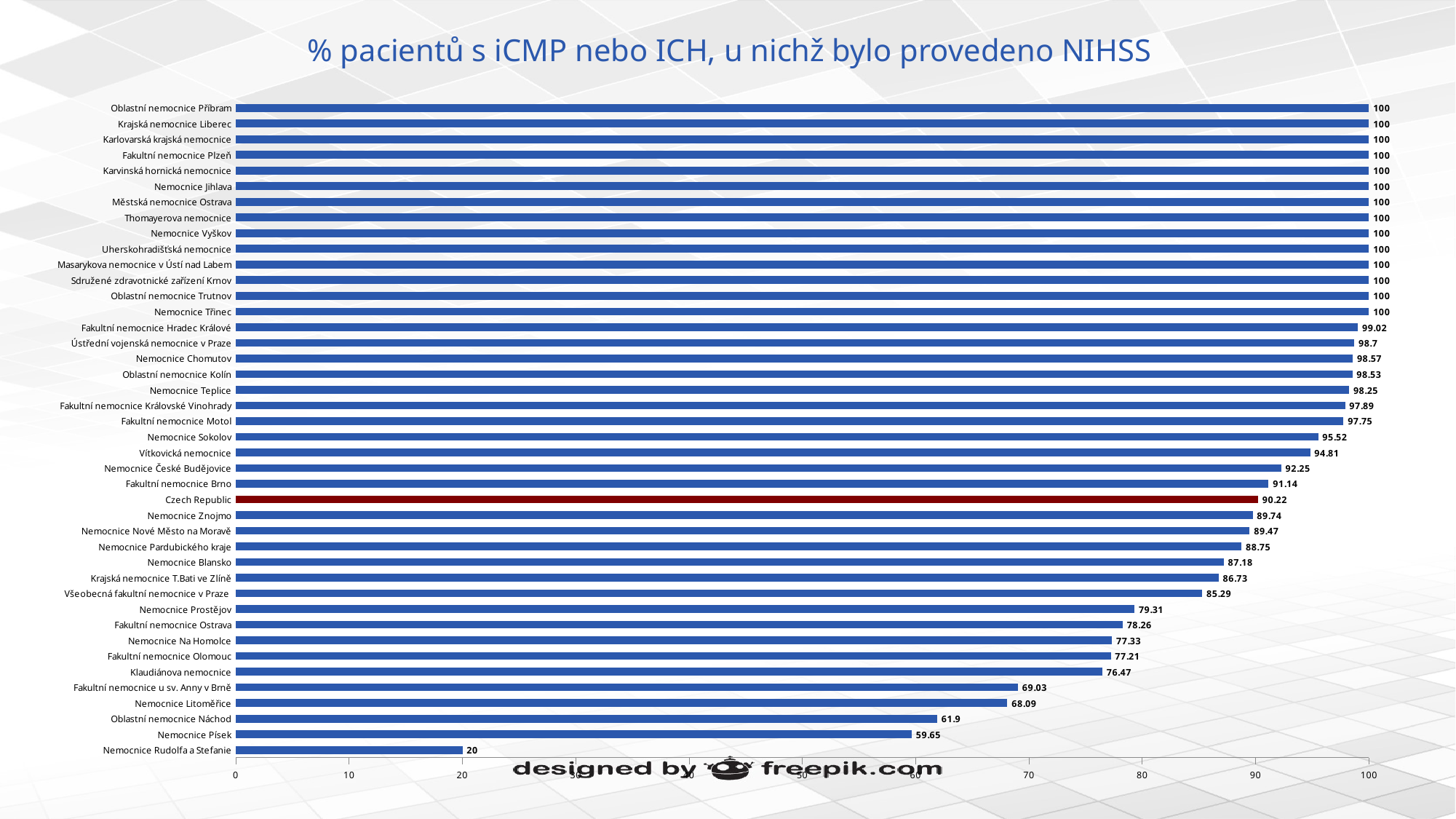
What kind of chart is shown on the slide? Bar chart Which category has the lowest value? Nemocnice Rudolfa a Stefanie What is the value for Czech Republic? 90.22 Which is larger, the value for Nemocnice Litoměřice or the value for Oblastní nemocnice Náchod? Nemocnice Litoměřice What is the difference between the values for Czech Republic and Nemocnice Znojmo? 0.48 What is the title of the chart? % pacientů s iCMP nebo ICH, u nichž bylo provedeno NIHSS What is the value for Nemocnice Písek? 59.65 What is the difference between the values for Fakultní nemocnice Hradec Králové and Nemocnice Rudolfa a Stefanie? 79.02 Which bar is coloured differently (dark red) from the others? Czech Republic What is the value for Fakultní nemocnice Motol? 97.75 What is the value for Nemocnice Rudolfa a Stefanie? 20 How many categories are shown in the chart? 42